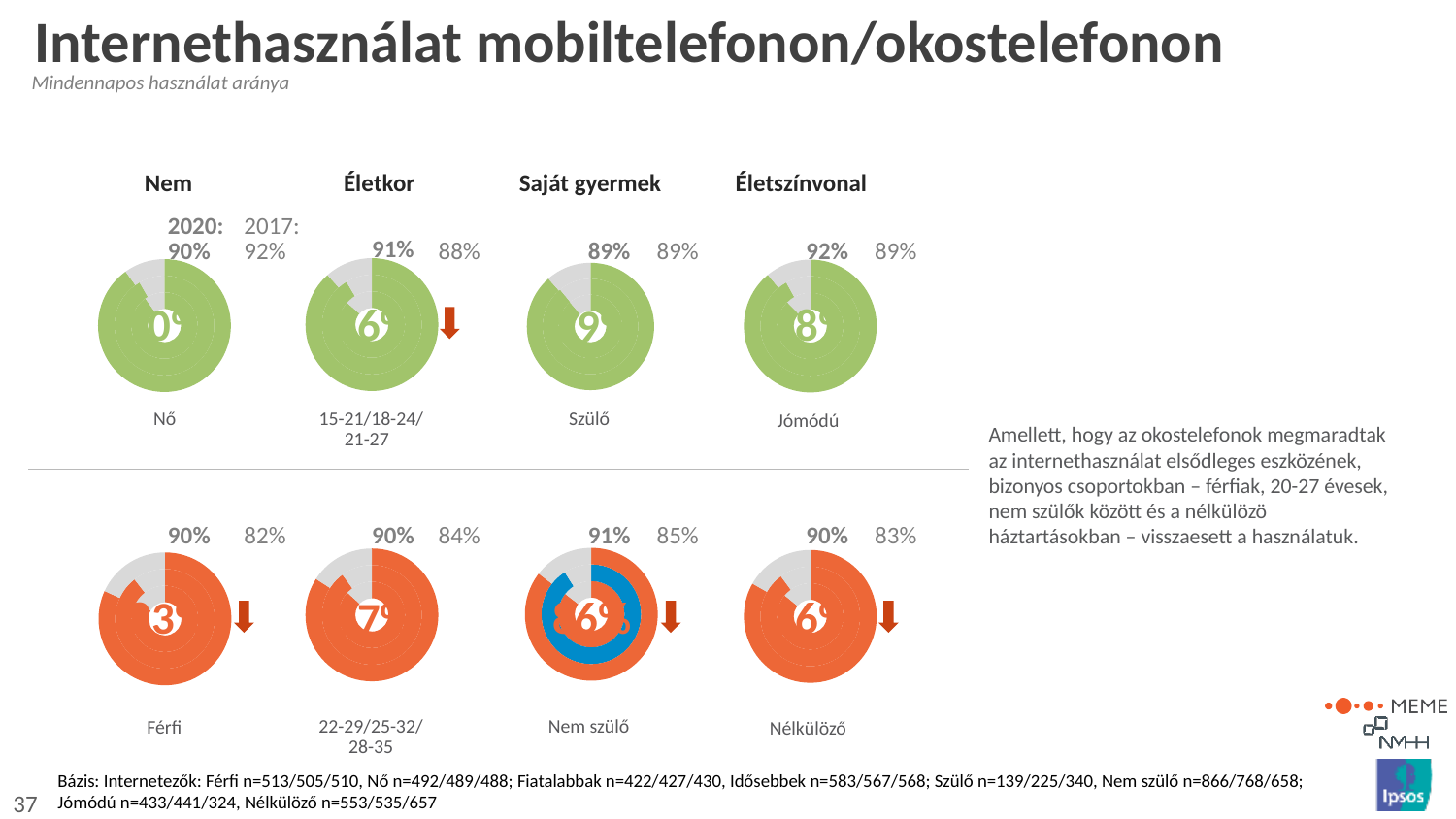
What is the 2017 value shown for the Férfi chart? 82% Which chart has the lowest 2017 value among the eight charts? Férfi What is the 2017 value shown for the Nő chart? 92% What is the 2020 value shown for the Jómódú chart? 92% What is the 2017 value shown for the Nélkülöző chart? 83% What is the 2020 value shown for the Szülő chart? 89% Is the 2017 value on the Nő chart larger or smaller than the 2017 value on the Férfi chart? larger What is the 2020 value shown for the Nő chart? 90% Which chart has the highest 2020 value among the eight charts? Jómódú How many donut charts are shown on the slide? 8 What is the 2020 value shown for the Nem szülő chart? 91% What is the difference between the 2020 and 2017 values on the Férfi chart? 8 percentage points